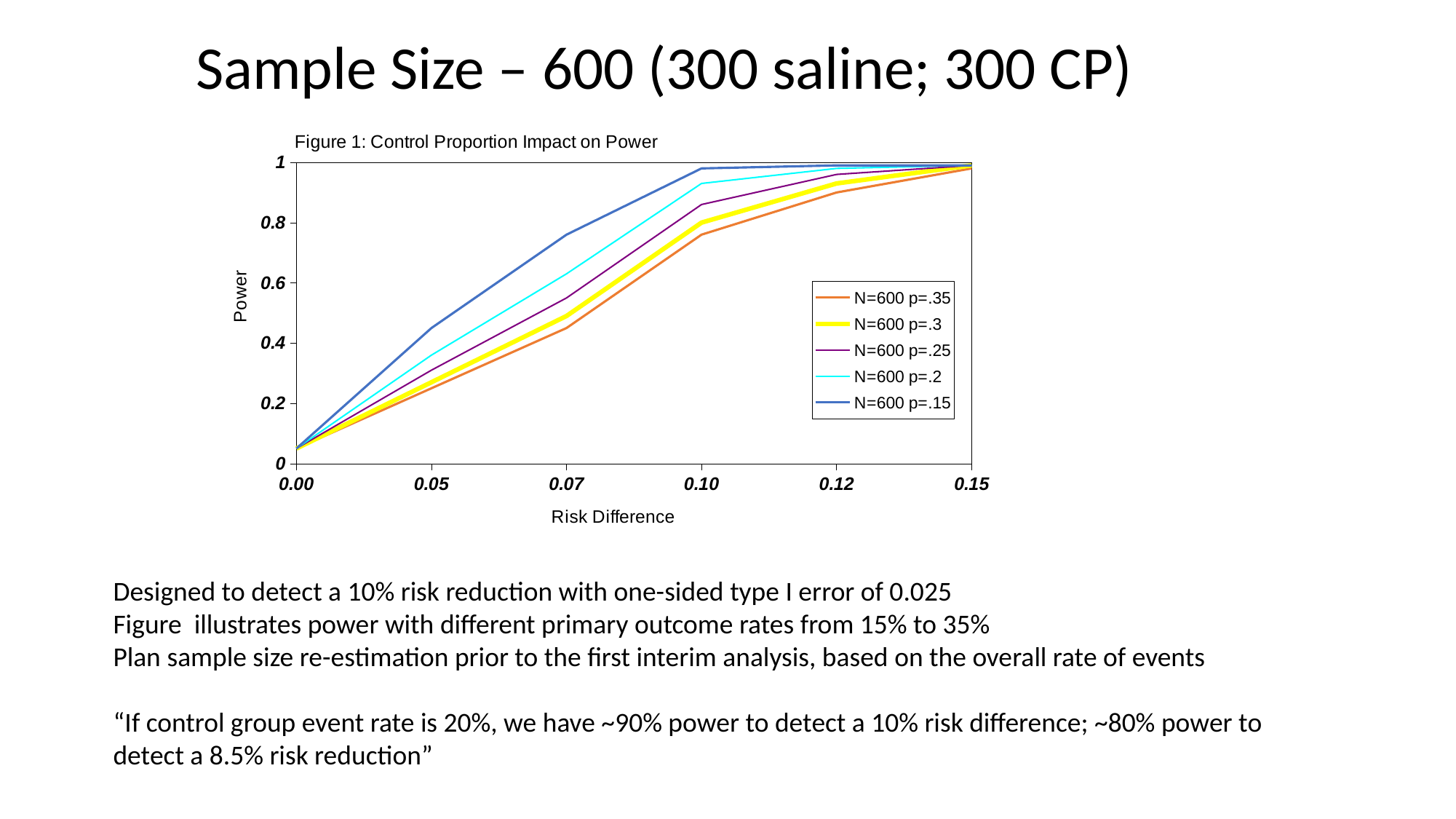
Is the power for N=600 p=.35 at a Risk Difference of 0.10 greater or less than 0.8? less What is the title of the chart on the slide? Figure 1: Control Proportion Impact on Power Which series has the highest power at a Risk Difference of 0.05? N=600 p=.15 How many series does the legend of the chart list? 5 Does the power for N=600 p=.15 rise or fall as Risk Difference increases from 0.00 to 0.15? rise Which series has the lowest power at a Risk Difference of 0.10? N=600 p=.35 At a Risk Difference of 0.07, which series has the larger power: N=600 p=.15 or N=600 p=.35? N=600 p=.15 What is the label of the x axis of the chart? Risk Difference Is the power for N=600 p=.2 at a Risk Difference of 0.07 greater or less than 0.8? less What kind of chart is shown in Figure 1: Control Proportion Impact on Power? line chart Is the power for N=600 p=.15 at a Risk Difference of 0.10 greater or less than 0.8? greater How many Risk Difference values are marked on the x axis of the chart? 6